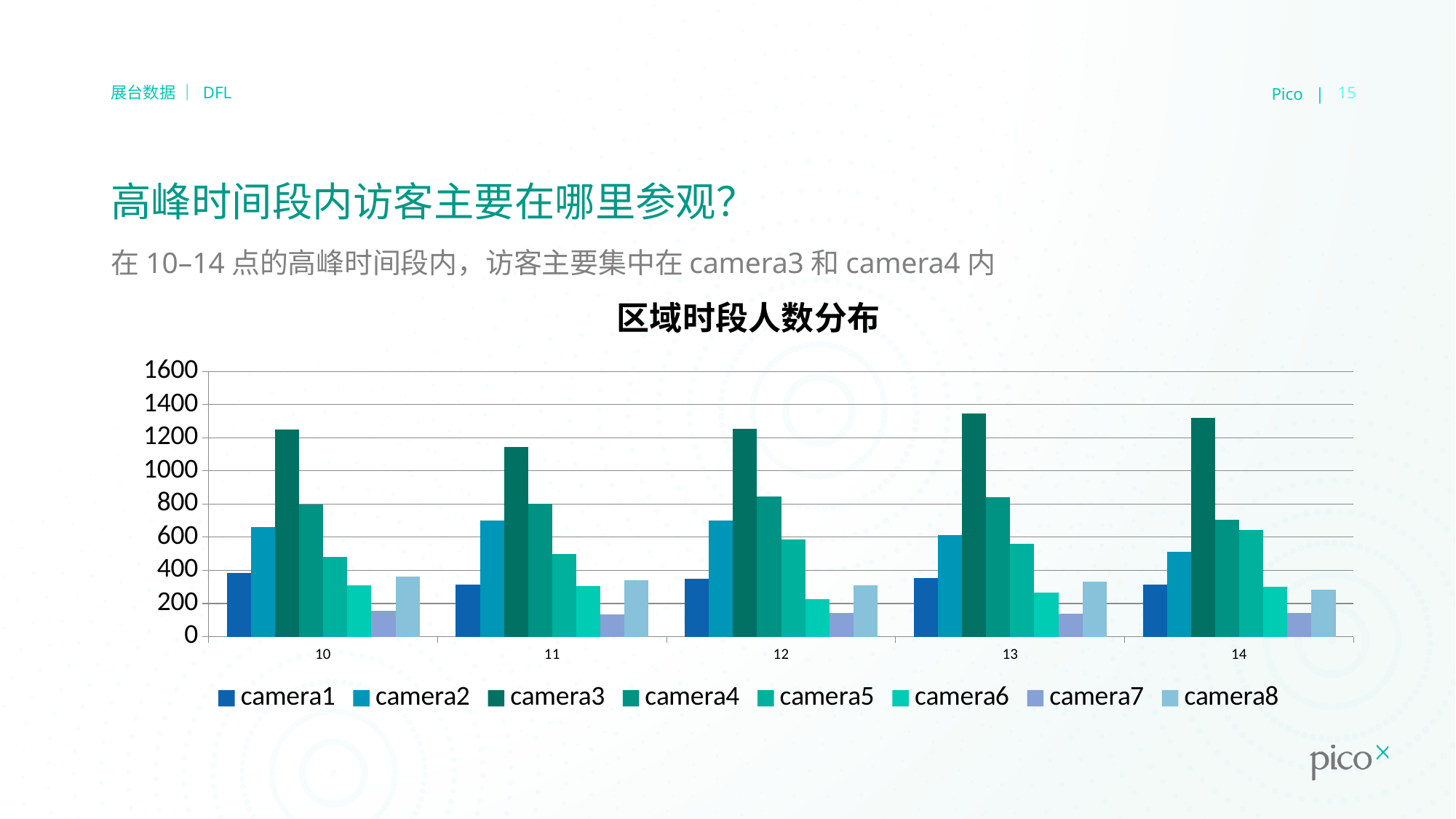
What kind of chart is shown on the slide? bar chart Which camera has the lowest bar in the 12 o'clock group? camera7 How many time-slot categories are shown on the x axis? 5 Is the value for camera3 at 13 greater or less than 1200? greater Which is larger: camera2 at 10 or camera2 at 14? camera2 at 10 Is the value for camera4 at 10 greater or less than 1000? less What is the title of the chart? 区域时段人数分布 Is the value for camera6 at 12 greater or less than 400? less Which camera has the highest bar in the 10 o'clock group? camera3 Which is larger: camera3 at 13 or camera3 at 11? camera3 at 13 How many series does the legend list? 8